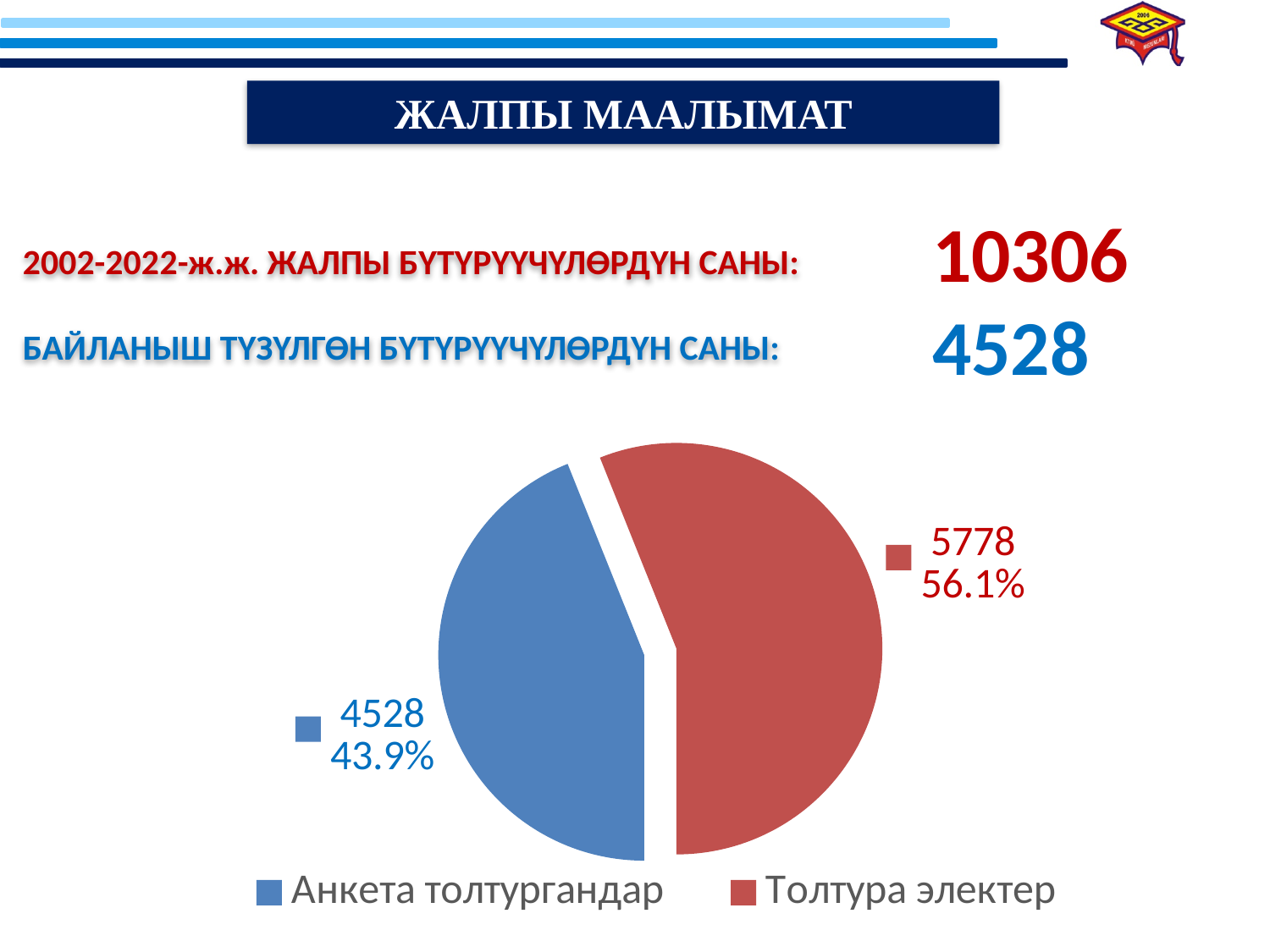
What is the value for Анкета толтургандар in the pie chart? 4528 What is the difference between the values for Толтура электер and Анкета толтургандар? 1250 What kind of chart is shown on the slide? pie chart What share of the pie does Толтура электер represent? 56.1% How many slices does the pie chart have? 2 Which is larger, the value for Анкета толтургандар or the value for Толтура электер? Толтура электер What is the value for Толтура электер in the pie chart? 5778 What is the total of the two values shown in the pie chart? 10306 What share of the pie does Анкета толтургандар represent? 43.9% Which slice of the pie chart is the largest? Толтура электер What colour is the Толтура электер slice in the pie chart? red Which slice of the pie chart is the smallest? Анкета толтургандар